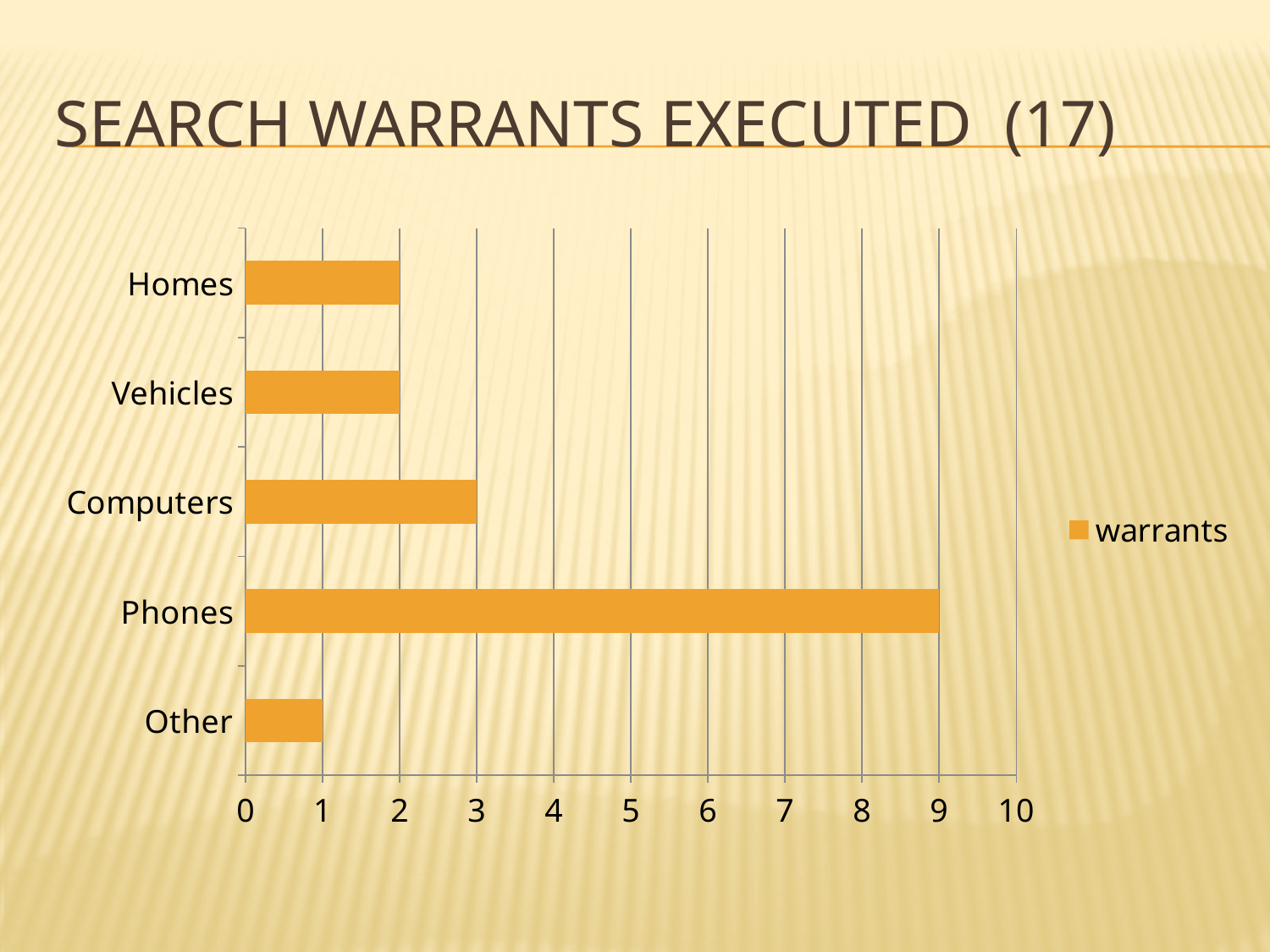
Which category has the lowest value? Other What is the value for Phones? 9 Which category has the highest value? Phones What kind of chart is shown on the slide? bar chart What is the value for Homes? 2 What is the value for Computers? 3 How many categories are shown on the chart? 5 Which is larger, the value for Computers or the value for Vehicles? Computers What series name does the legend show? warrants What is the value for Other? 1 Is the value for Phones greater or less than 5? greater What is the difference between the values for Phones and Computers? 6